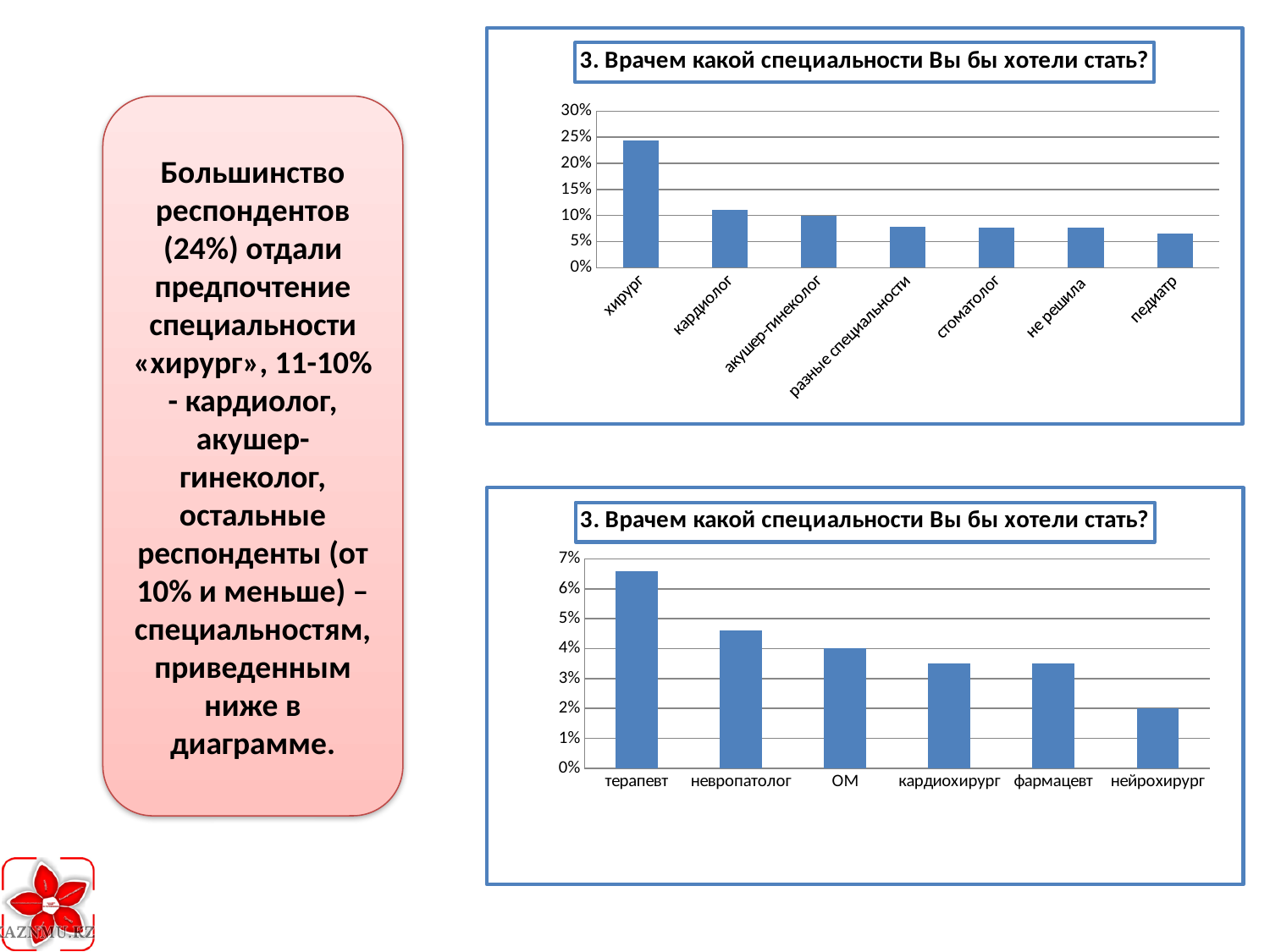
In the bottom chart, which specialty has the lowest value? нейрохирург In the top chart, is the value for кардиолог greater or less than 15%? less In the top chart, how many specialties (categories) are shown on the x axis? 7 What type of chart is the top chart on the slide? bar chart In the top chart, do the values rise or fall from left to right along the x axis? fall In the top chart, which specialty has the highest value? хирург In the top chart, which specialty has the lowest value? педиатр In the top chart, which has a larger value: хирург or кардиолог? хирург In the bottom chart, which specialty has the highest value? терапевт In the top chart, is the value for хирург greater or less than 20%? greater In the bottom chart, is the value for терапевт greater or less than 6%? greater In the bottom chart, how many specialties (categories) are shown on the x axis? 6